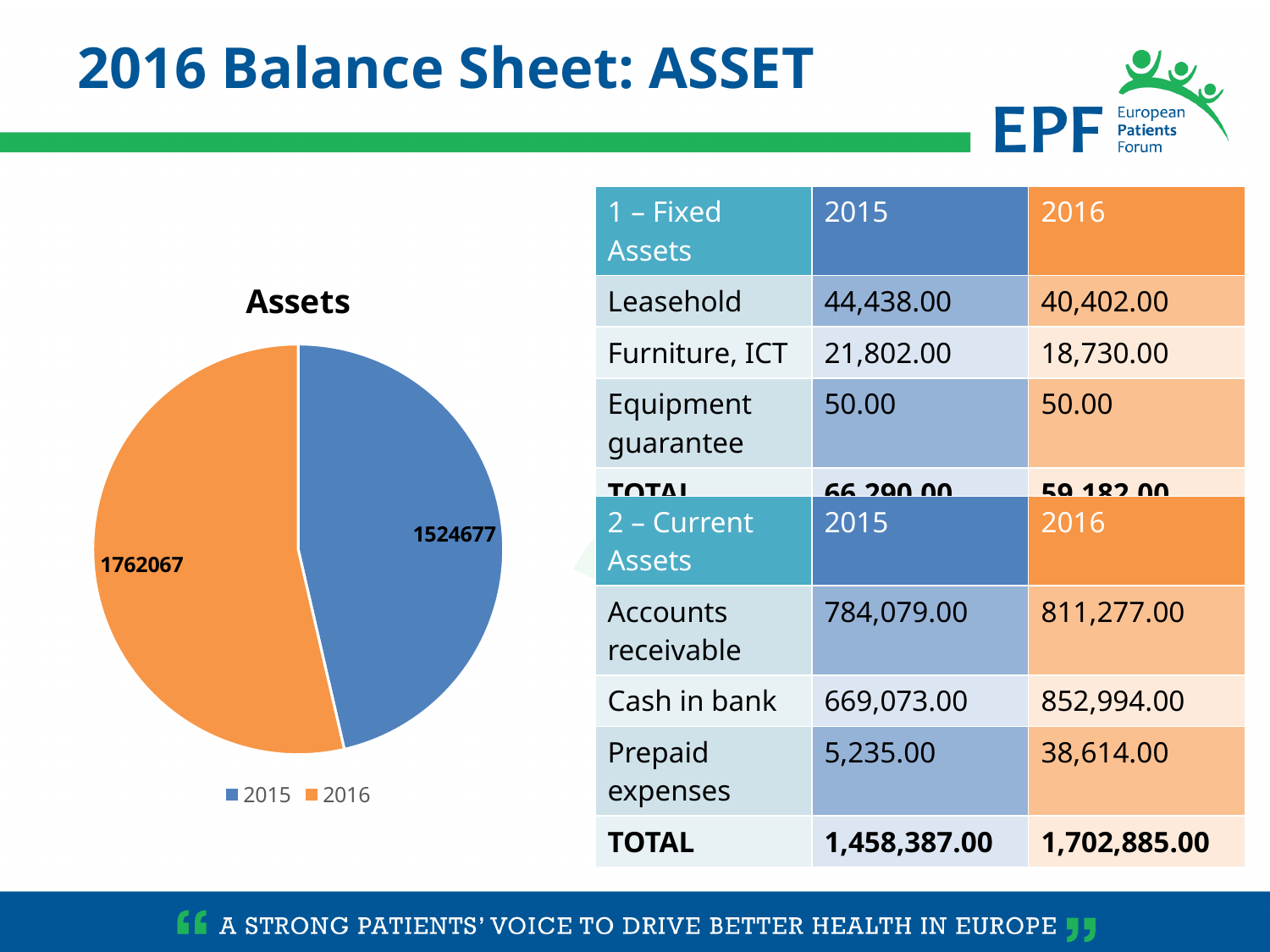
How many entries does the legend of the Assets pie chart list? 2 What value is shown for the 2016 slice of the Assets pie chart? 1762067 In the Assets pie chart, is the value for 2016 larger or smaller than the value for 2015? larger What type of chart is used to show the Assets data on the slide? pie chart What value is shown for the 2015 slice of the Assets pie chart? 1524677 What is the total of the two slices in the Assets pie chart? 3286744 How many slices does the Assets pie chart have? 2 Which year has the larger slice in the Assets pie chart? 2016 Which colour represents 2016 in the Assets pie chart? orange What is the title of the chart on the slide? Assets Which year has the smaller slice in the Assets pie chart? 2015 What is the difference between the 2016 and 2015 values in the Assets pie chart? 237390